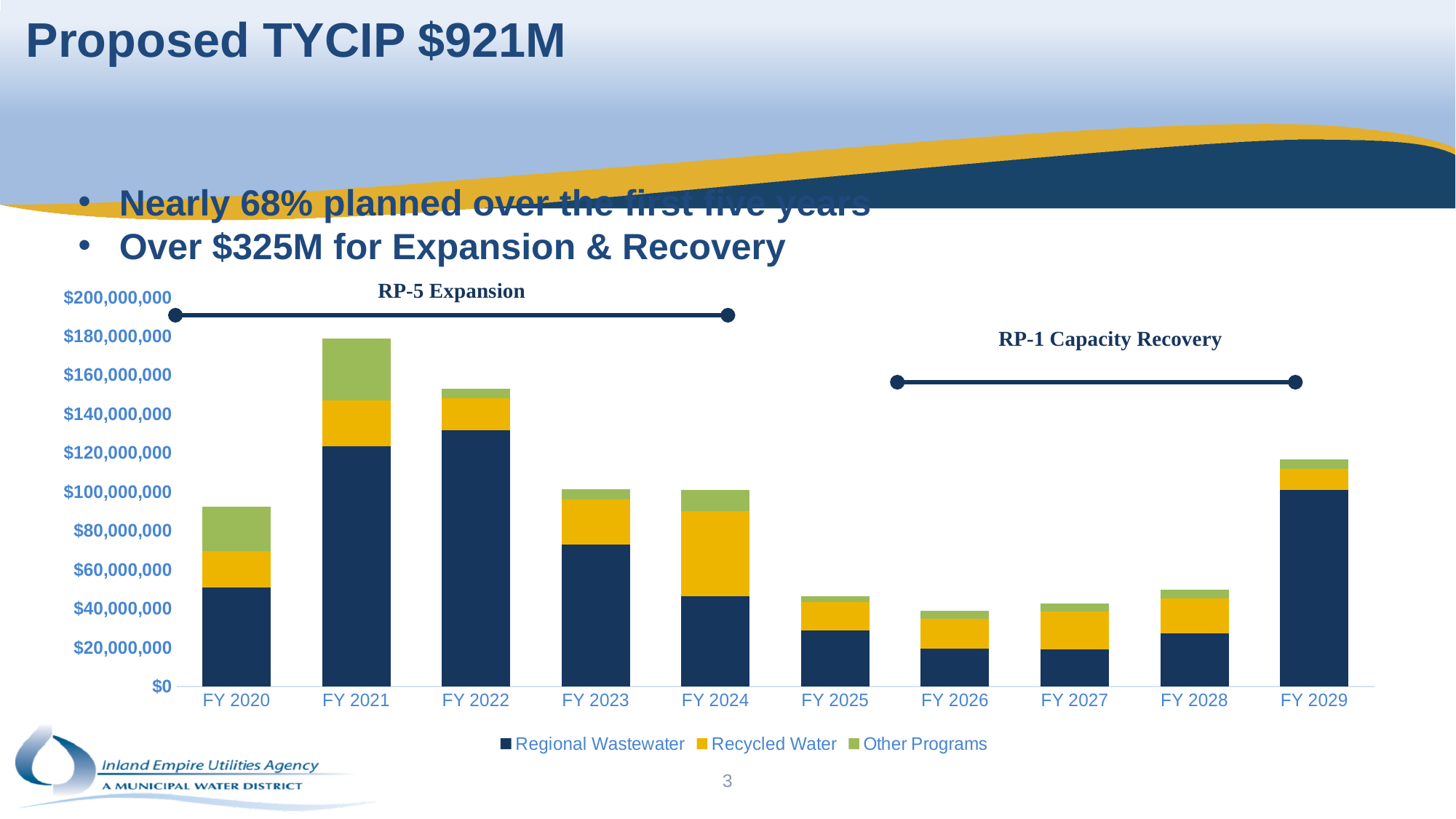
What kind of chart is shown on the slide? Stacked bar chart Which has the larger total bar, FY 2020 or FY 2029? FY 2029 Is the total bar for FY 2025 greater or less than $60,000,000? less How many series does the chart legend list? 3 Do the total bars rise or fall from FY 2022 to FY 2026? fall Which fiscal year has the highest total bar in the chart? FY 2021 Is the Regional Wastewater segment for FY 2022 greater or less than $120,000,000? greater How many fiscal years are shown on the x axis of the chart? 10 Is the total bar for FY 2021 greater or less than $160,000,000? greater Which has the larger total bar, FY 2022 or FY 2023? FY 2022 Which series is shown in green in the chart legend? Other Programs